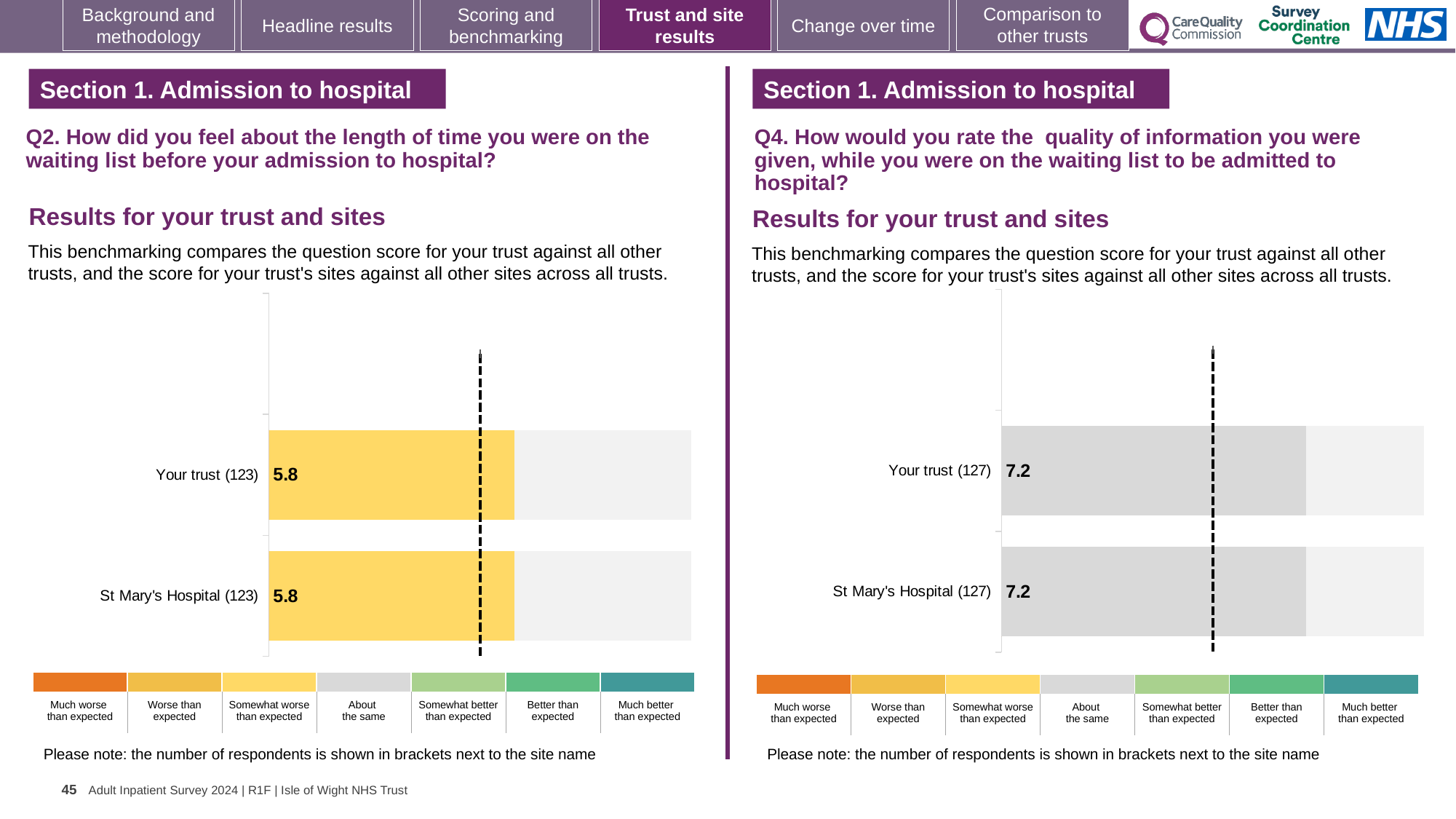
On the Q2 chart (left), which benchmark category does the bar colour for Your trust correspond to? Somewhat worse than expected On the Q4 chart (right), what is the score for St Mary's Hospital (127)? 7.2 How many bars are plotted on the Q2 chart (left)? 2 How many bars are plotted on the Q4 chart (right)? 2 On the Q2 chart (left), what is the score for St Mary's Hospital (123)? 5.8 On the Q2 chart (left), what is the difference between the score for Your trust and the score for St Mary's Hospital? 0.0 On the Q4 chart (right), what is the score for Your trust (127)? 7.2 On the Q4 chart (right), what is the difference between the score for Your trust and the score for St Mary's Hospital? 0.0 On the Q4 chart (right), which benchmark category does the bar colour for Your trust correspond to? About the same On the Q2 chart (left), how many respondents are shown in brackets for St Mary's Hospital? 123 What type of chart is used on the Q2 chart (left)? Bar chart On the Q2 chart (left), what is the score for Your trust (123)? 5.8